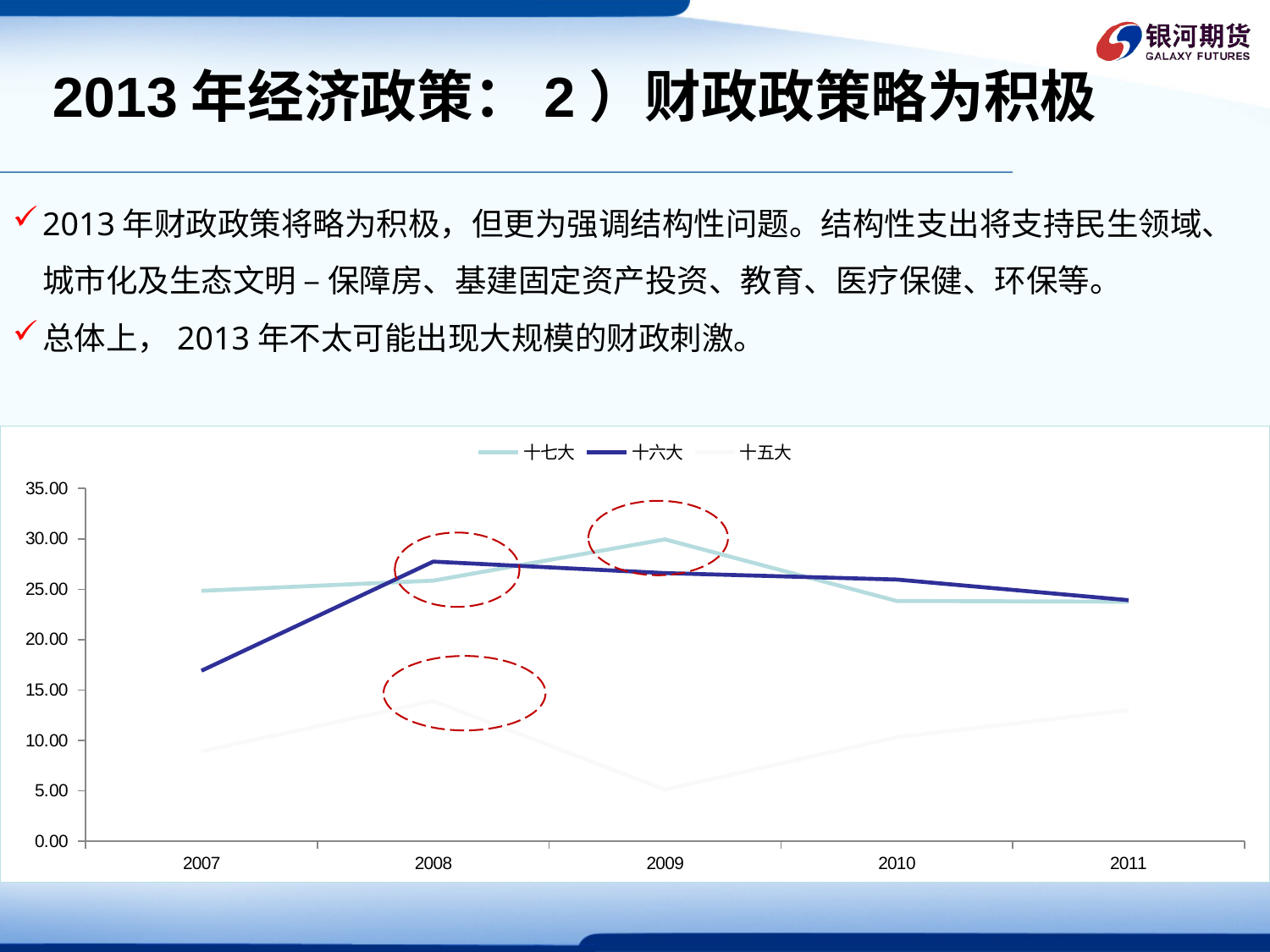
Is the value for 十五大 in 2009 greater or less than 10.00? less In which year does the 十五大 series have its lowest value? 2009 How many years are shown along the x axis? 5 What are the three series names listed in the legend? 十七大, 十六大, 十五大 How many series does the legend list? 3 Is the value for 十六大 in 2007 greater or less than 20.00? less Is the value for 十七大 in 2009 greater or less than 25.00? greater In which year does the 十六大 series have its lowest value? 2007 What kind of chart is shown on the slide? line chart In 2007, which series has the larger value, 十七大 or 十六大? 十七大 Does the 十六大 series rise or fall from 2008 to 2011? fall In which year does the 十七大 series reach its highest value? 2009